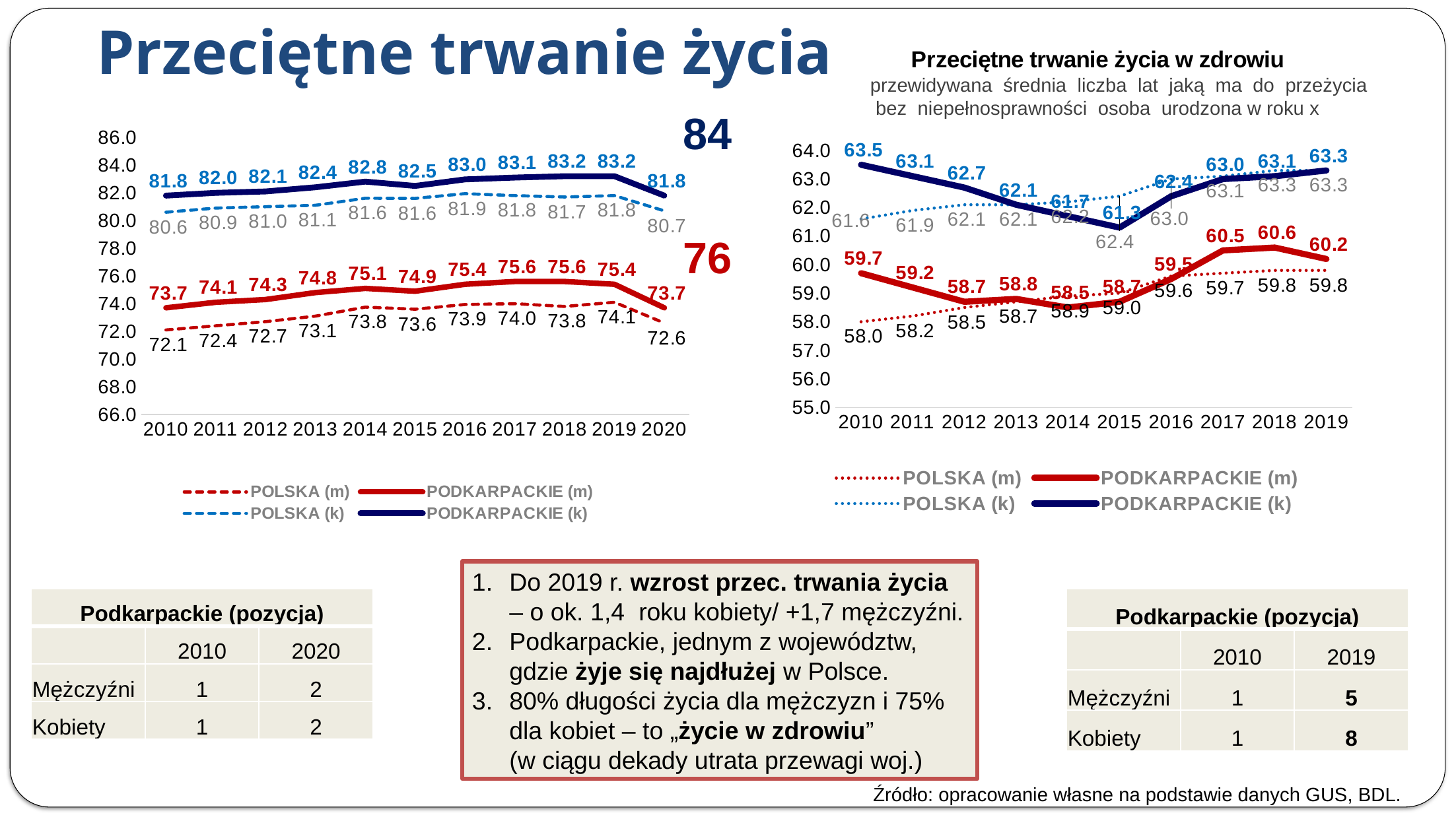
On the left chart, how many series does the legend list? 4 On the 'Przeciętne trwanie życia w zdrowiu' chart, what is the value for PODKARPACKIE (m) in 2018? 60.6 On the 'Przeciętne trwanie życia w zdrowiu' chart, does POLSKA (m) rise or fall from 2010 to 2019? rise On the left chart, in which year does PODKARPACKIE (m) reach its highest value? 2017 and 2018 (75.6) What type of chart is the 'Przeciętne trwanie życia w zdrowiu' chart? line chart On the left chart, how many years are shown on the x axis? 11 On the left chart, what is the value for POLSKA (m) in 2010? 72.1 On the 'Przeciętne trwanie życia w zdrowiu' chart, which is larger in 2010: PODKARPACKIE (k) or POLSKA (k)? PODKARPACKIE (k) On the left chart, what is the value for PODKARPACKIE (k) in 2019? 83.2 On the 'Przeciętne trwanie życia w zdrowiu' chart, what is the difference between PODKARPACKIE (m) in 2019 and POLSKA (m) in 2019? 0.4 On the 'Przeciętne trwanie życia w zdrowiu' chart, in which year is PODKARPACKIE (k) lowest? 2015 On the left chart, what is the difference between PODKARPACKIE (k) and POLSKA (k) in 2020? 1.1